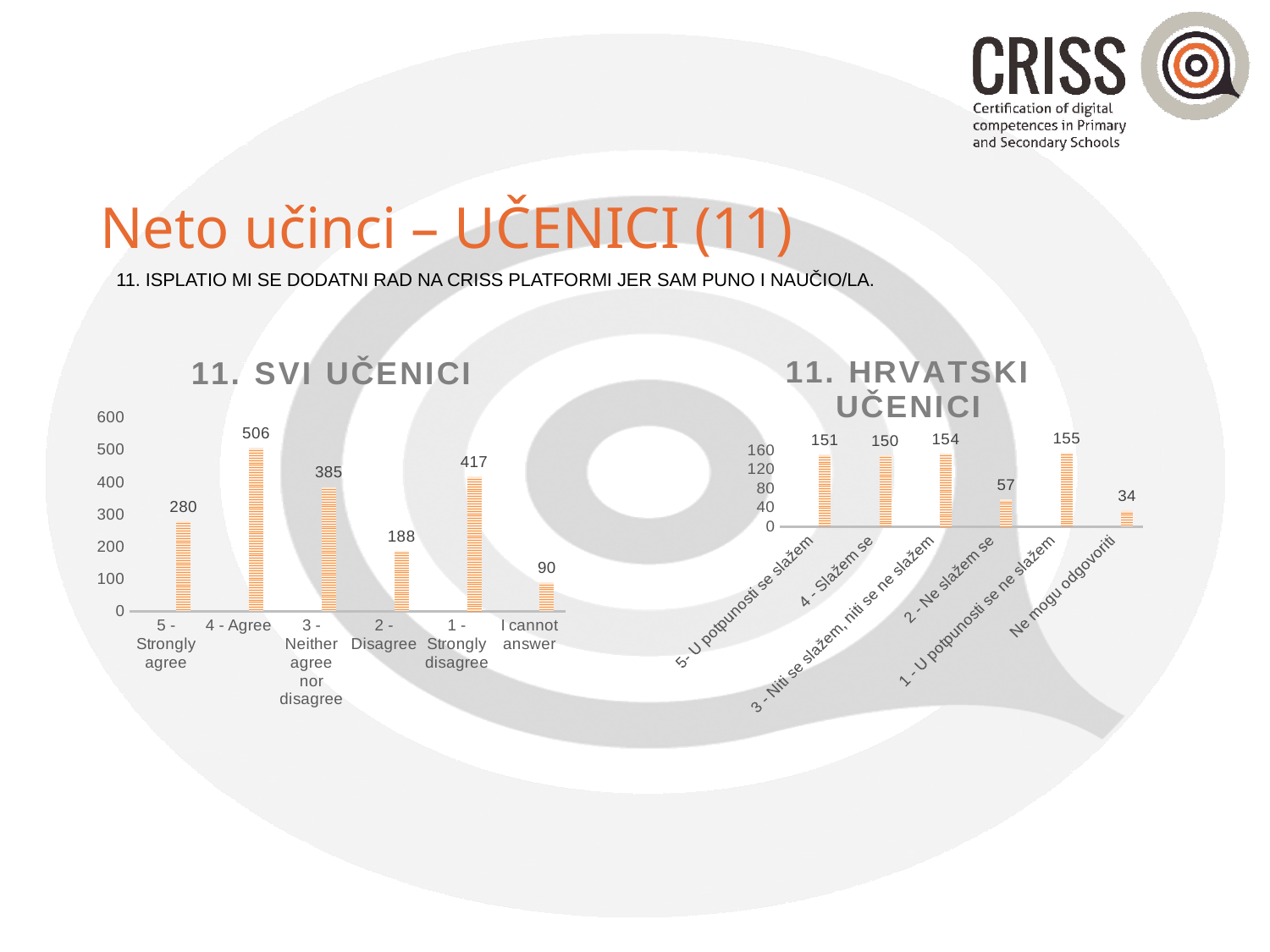
In the "11. HRVATSKI UČENICI" chart, what is the value for "2 - Ne slažem se"? 57 In the "11. SVI UČENICI" chart, what is the value for "4 - Agree"? 506 How many categories are shown in the "11. SVI UČENICI" chart? 6 In the "11. SVI UČENICI" chart, which category has the lowest value? I cannot answer In the "11. SVI UČENICI" chart, what is the difference between the values for "4 - Agree" and "1 - Strongly disagree"? 89 What kind of chart is the "11. HRVATSKI UČENICI" chart? bar chart In the "11. HRVATSKI UČENICI" chart, is the value for "1 - U potpunosti se ne slažem" greater or less than 120? greater In the "11. SVI UČENICI" chart, which category has the highest value? 4 - Agree In the "11. SVI UČENICI" chart, what is the value for "I cannot answer"? 90 In the "11. SVI UČENICI" chart, which is larger: the value for "5 - Strongly agree" or the value for "3 - Neither agree nor disagree"? 3 - Neither agree nor disagree In the "11. HRVATSKI UČENICI" chart, which category has the lowest value? Ne mogu odgovoriti In the "11. HRVATSKI UČENICI" chart, what is the difference between the values for "3 - Niti se slažem, niti se ne slažem" and "Ne mogu odgovoriti"? 120